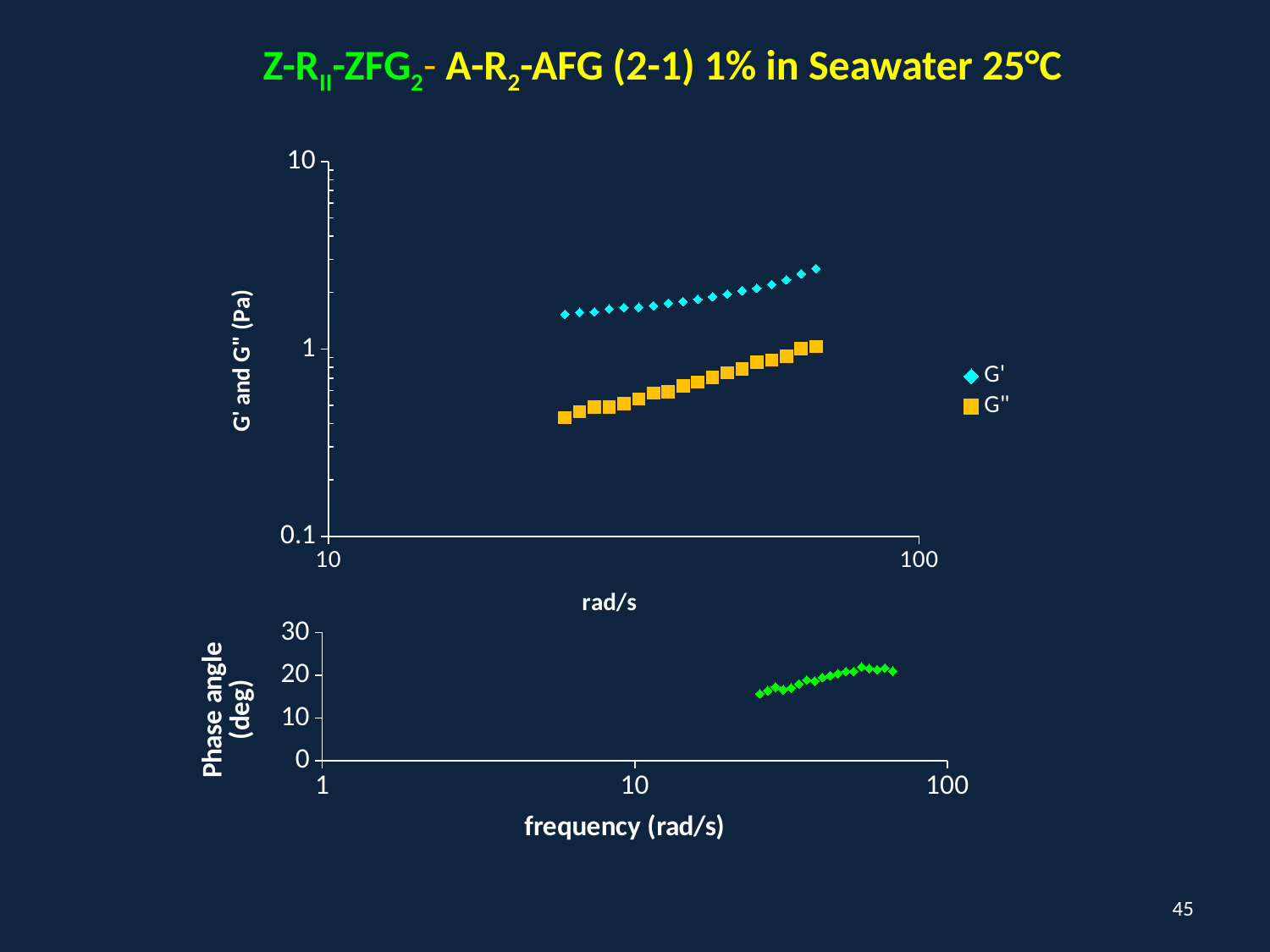
In the top chart, do the G' values rise or fall as frequency increases? rise In the top chart, is the G' value at the lowest frequency greater or less than 1? greater How many series does the legend of the top chart list? 2 In the top chart, is the G'' value at the lowest frequency greater or less than 1? less In the top chart, is the G' value at the highest frequency greater or less than 10? less In the top chart, do the G'' values rise or fall as frequency increases? rise What kind of chart is the top chart showing G' and G'' against rad/s? scatter chart What is the y-axis label of the top chart? G' and G'' (Pa) In the bottom chart, does the phase angle rise or fall as frequency increases? rise In the top chart, which series has the larger values, G' or G''? G'